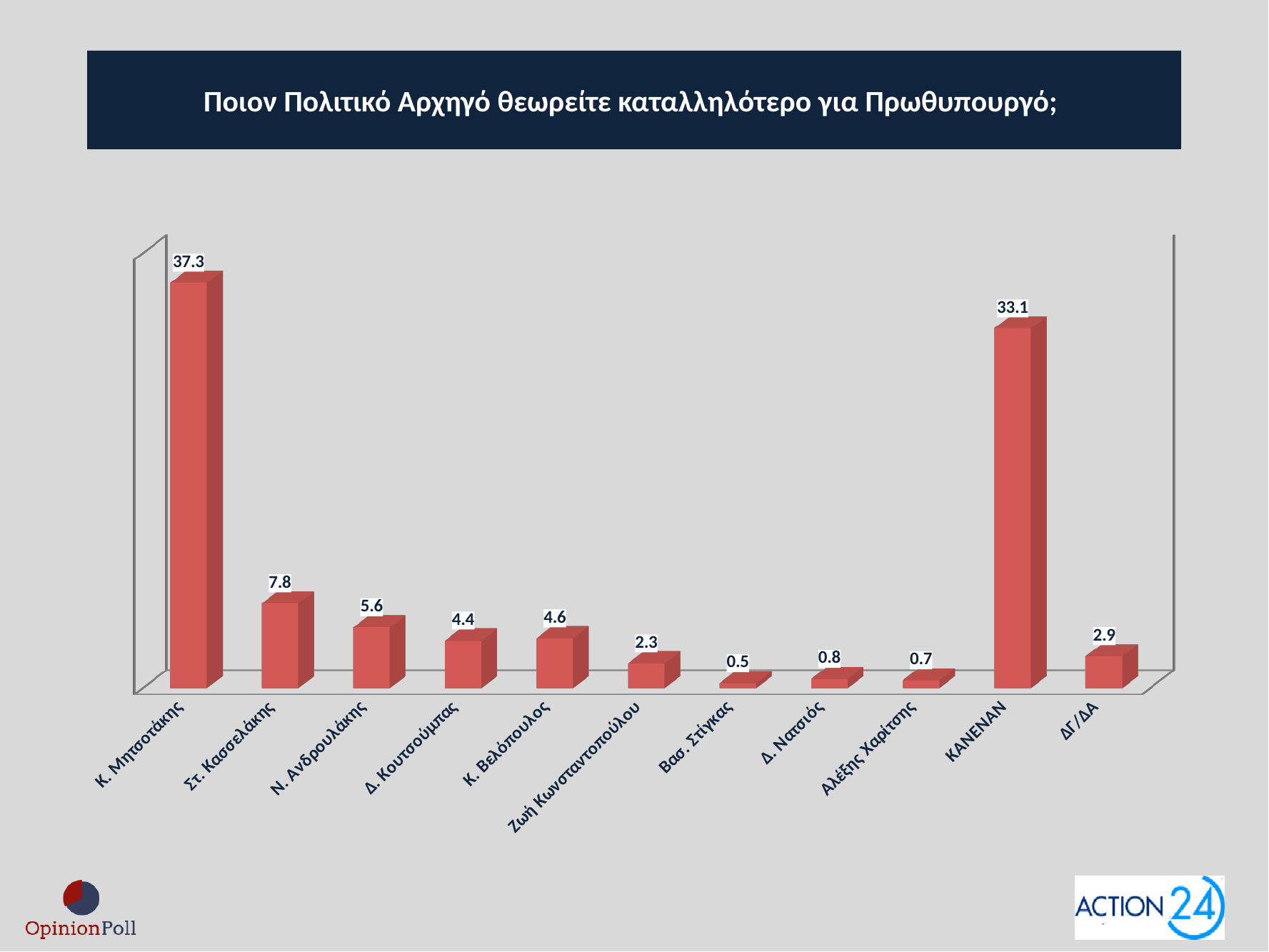
How many categories are shown in the chart? 11 What is the value for Στ. Κασσελάκης? 7.8 What is the value for Ζωή Κωνσταντοπούλου? 2.3 Which is larger, the value for Δ. Κουτσούμπας or the value for Κ. Βελόπουλος? Κ. Βελόπουλος What is the value for Κ. Μητσοτάκης? 37.3 What is the title of the chart? Ποιον Πολιτικό Αρχηγό θεωρείτε καταλληλότερο για Πρωθυπουργό; Which category has the lowest value? Βασ. Στίγκας Which category has the highest value? Κ. Μητσοτάκης What is the difference between the values for Στ. Κασσελάκης and Ν. Ανδρουλάκης? 2.2 What kind of chart is shown on the slide? Bar chart What is the difference between the values for Κ. Μητσοτάκης and ΚΑΝΕΝΑΝ? 4.2 What is the value for ΚΑΝΕΝΑΝ? 33.1